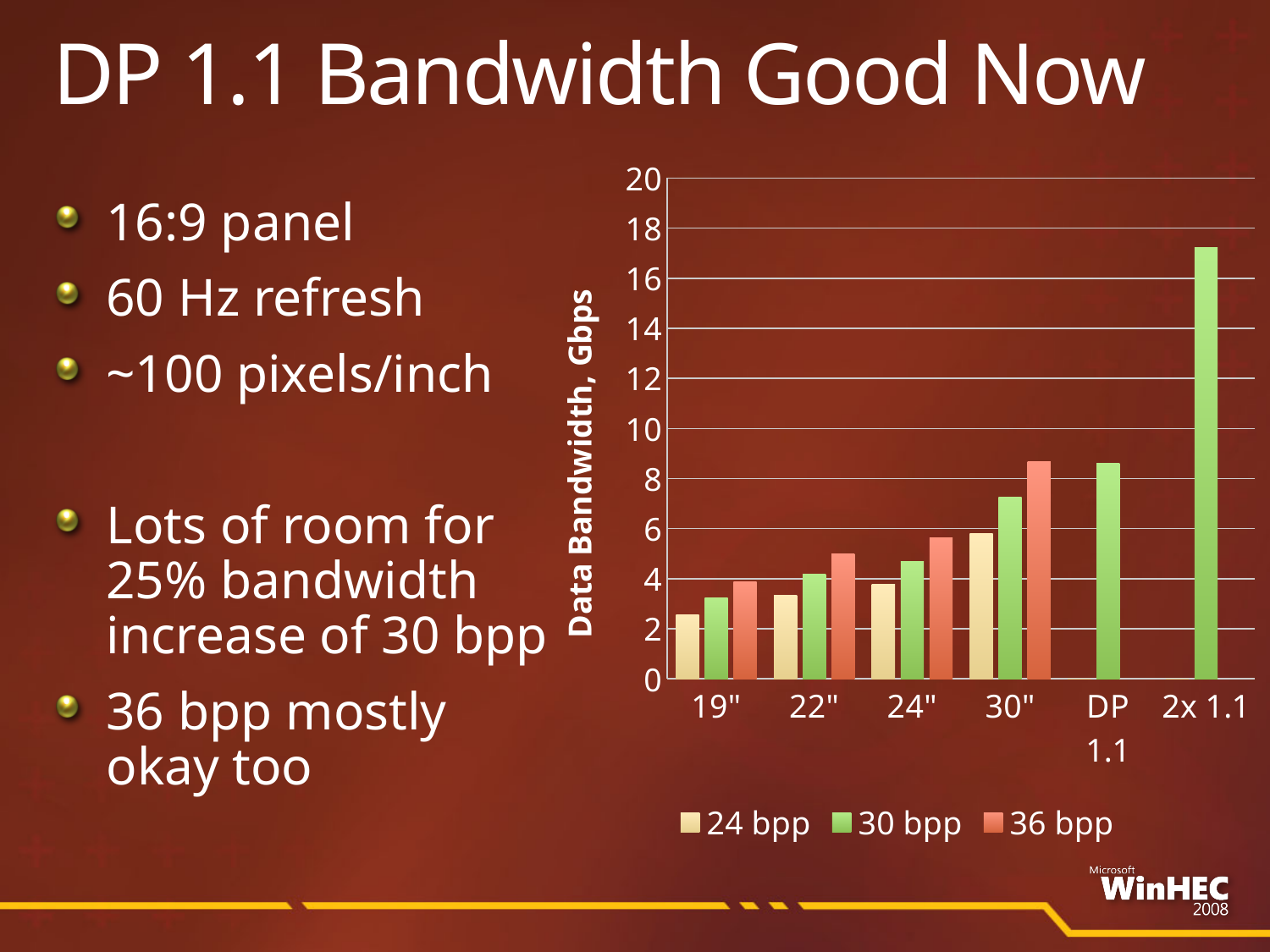
What is the label of the chart's vertical axis? Data Bandwidth, Gbps What kind of chart is shown on the slide? bar chart Which category has the tallest bar in the chart? 2x 1.1 Which bar is the lowest in the chart? 24 bpp for 19" Which is larger: the 30 bpp value for 30" or the 36 bpp value for 24"? 30 bpp for 30" Is the 30 bpp value for 24" greater or less than 6? less Is the 30 bpp value for DP 1.1 greater or less than 8? greater How many series does the chart legend list? 3 How many categories are shown on the x axis of the chart? 6 Is the value for 2x 1.1 greater or less than 16? greater Do the 36 bpp values rise or fall as the panel size goes from 19" to 30"? rise